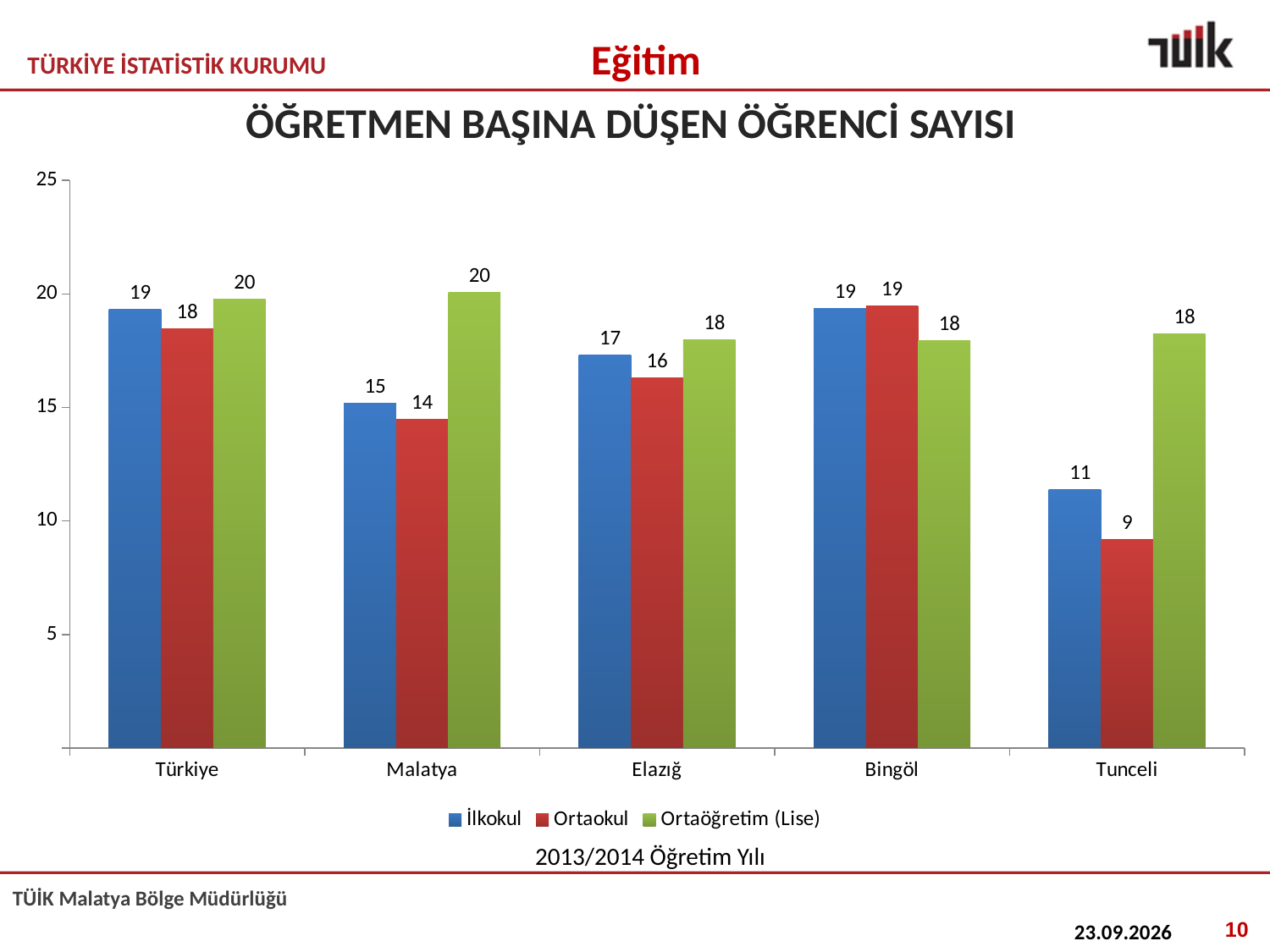
Which is larger for Elazığ, the İlkokul value or the Ortaokul value? İlkokul What is the Ortaöğretim (Lise) value for Elazığ? 18 What is the Ortaokul value for Tunceli? 9 What is the difference between the Ortaöğretim (Lise) value and the Ortaokul value for Malatya? 6 Which category has the lowest Ortaokul value? Tunceli Which category has the lowest İlkokul value? Tunceli What is the İlkokul value for Malatya? 15 Is the Ortaokul value for Tunceli greater or less than 10? less How many categories are shown on the x axis? 5 How many series does the legend list? 3 What is the title of the chart? ÖĞRETMEN BAŞINA DÜŞEN ÖĞRENCİ SAYISI What kind of chart is shown on the slide? bar chart